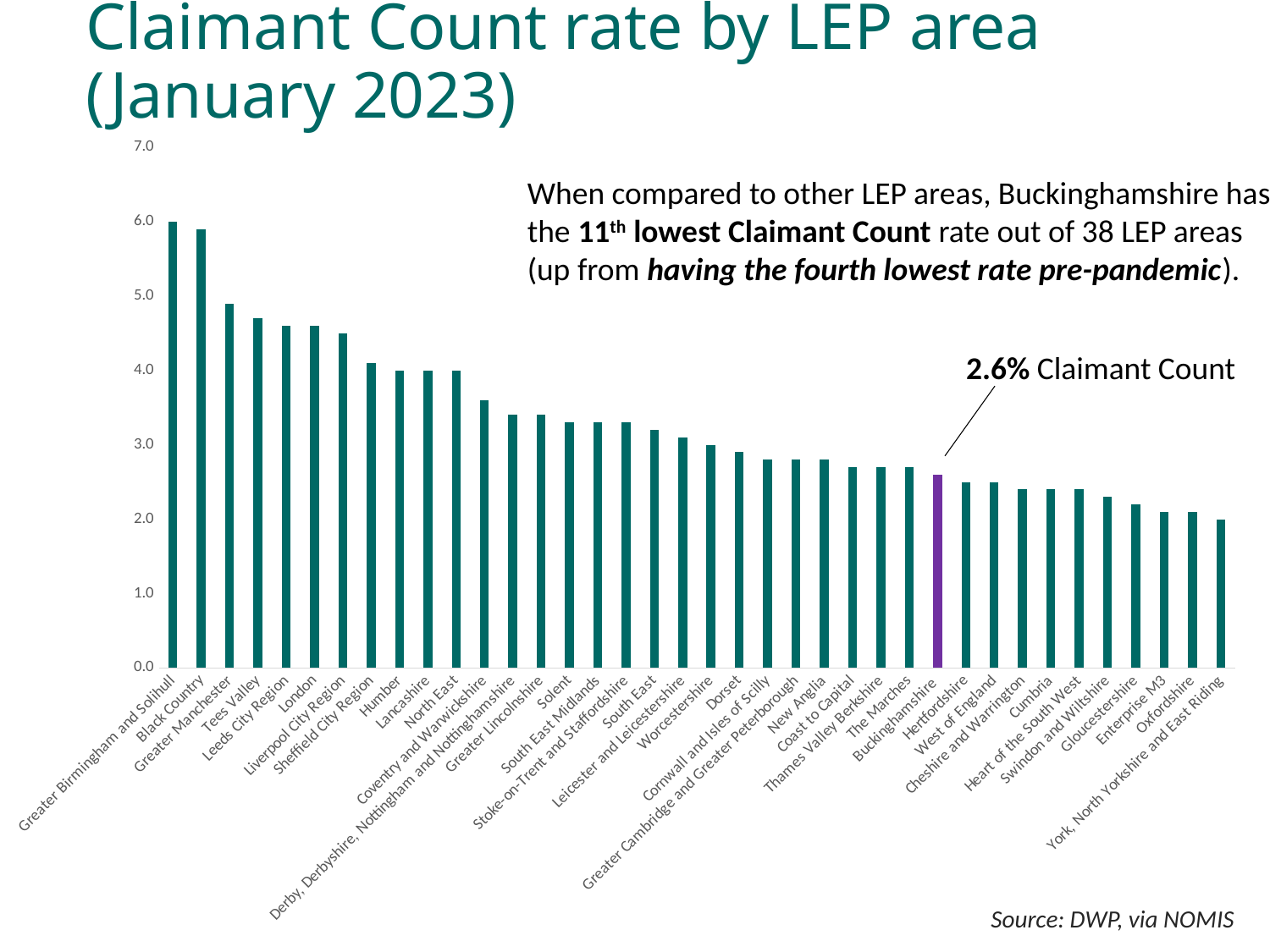
Which LEP area's bar is highlighted in purple? Buckinghamshire Which has a higher Claimant Count rate, Black Country or Oxfordshire? Black Country Which LEP area has the lowest Claimant Count rate? York, North Yorkshire and East Riding Is the value for London greater or less than 4.0? greater Is the value for Greater Manchester greater or less than 4.0? greater What is the Claimant Count rate for Buckinghamshire? 2.6% What kind of chart is shown on the slide? Bar chart How many LEP areas are plotted in the chart? 38 Which has a higher Claimant Count rate, Cumbria or London? London Is the value for Cumbria greater or less than 3.0? less Do the Claimant Count rates rise or fall moving from left to right along the x axis? Fall Which LEP area has the highest Claimant Count rate? Greater Birmingham and Solihull